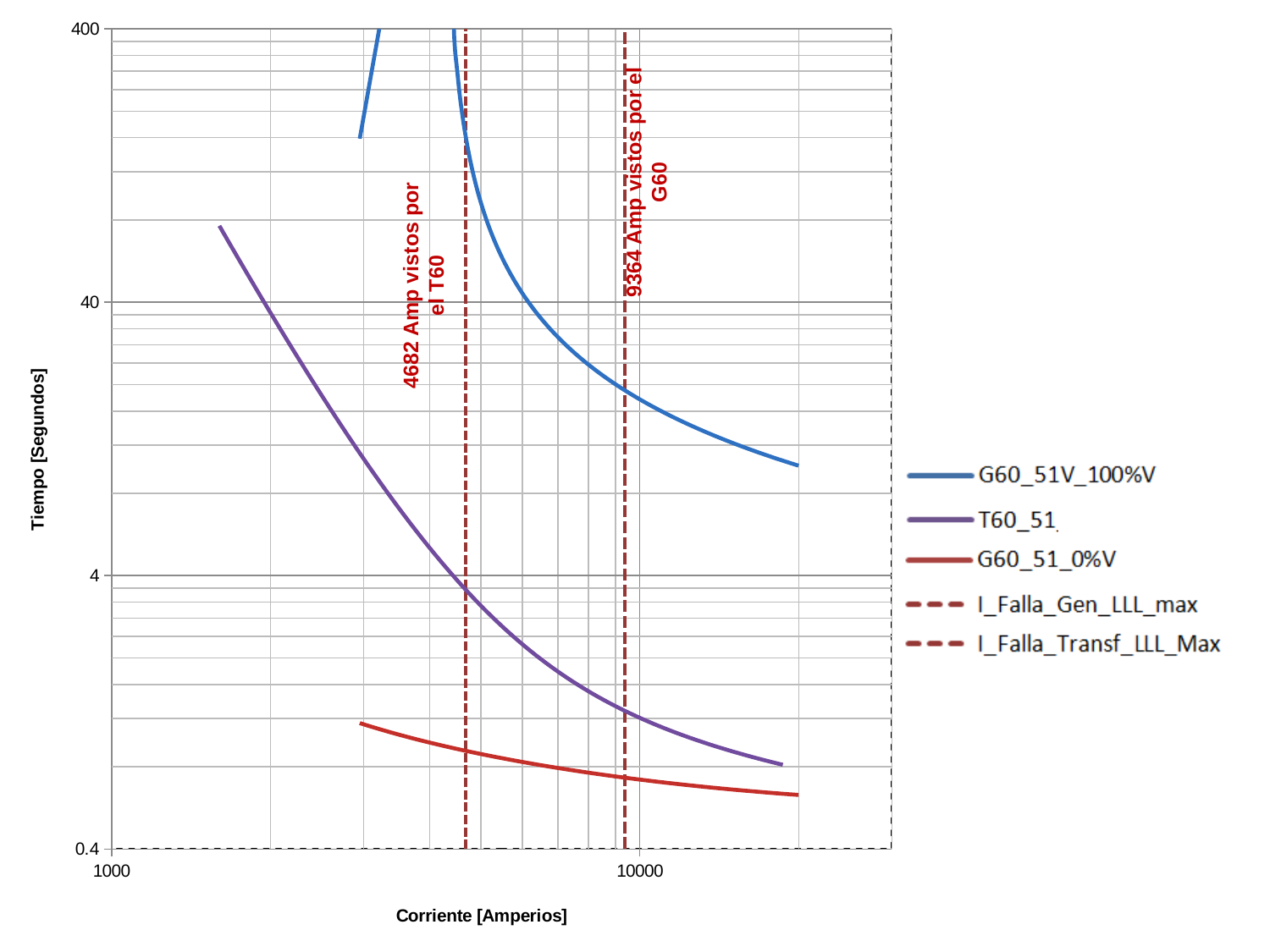
Do the time values of the T60_51 curve rise or fall as current increases? fall What is the label of the y axis? Tiempo [Segundos] At 10000 amps, is the time value for T60_51 greater or less than 4 seconds? less What is the label of the x axis? Corriente [Amperios] How many series does the legend list? 5 Which series has the lowest time values across the plotted current range? G60_51_0%V Which series has the highest time values across the plotted current range? G60_51V_100%V At 10000 amps, is the time value for G60_51V_100%V greater or less than 4 seconds? greater According to the annotation, how many amps are seen by the T60? 4682 Amp According to the annotation, how many amps are seen by the G60? 9364 Amp At 10000 amps, which series has the larger time value, G60_51V_100%V or T60_51? G60_51V_100%V What kind of chart is shown on the slide? line chart